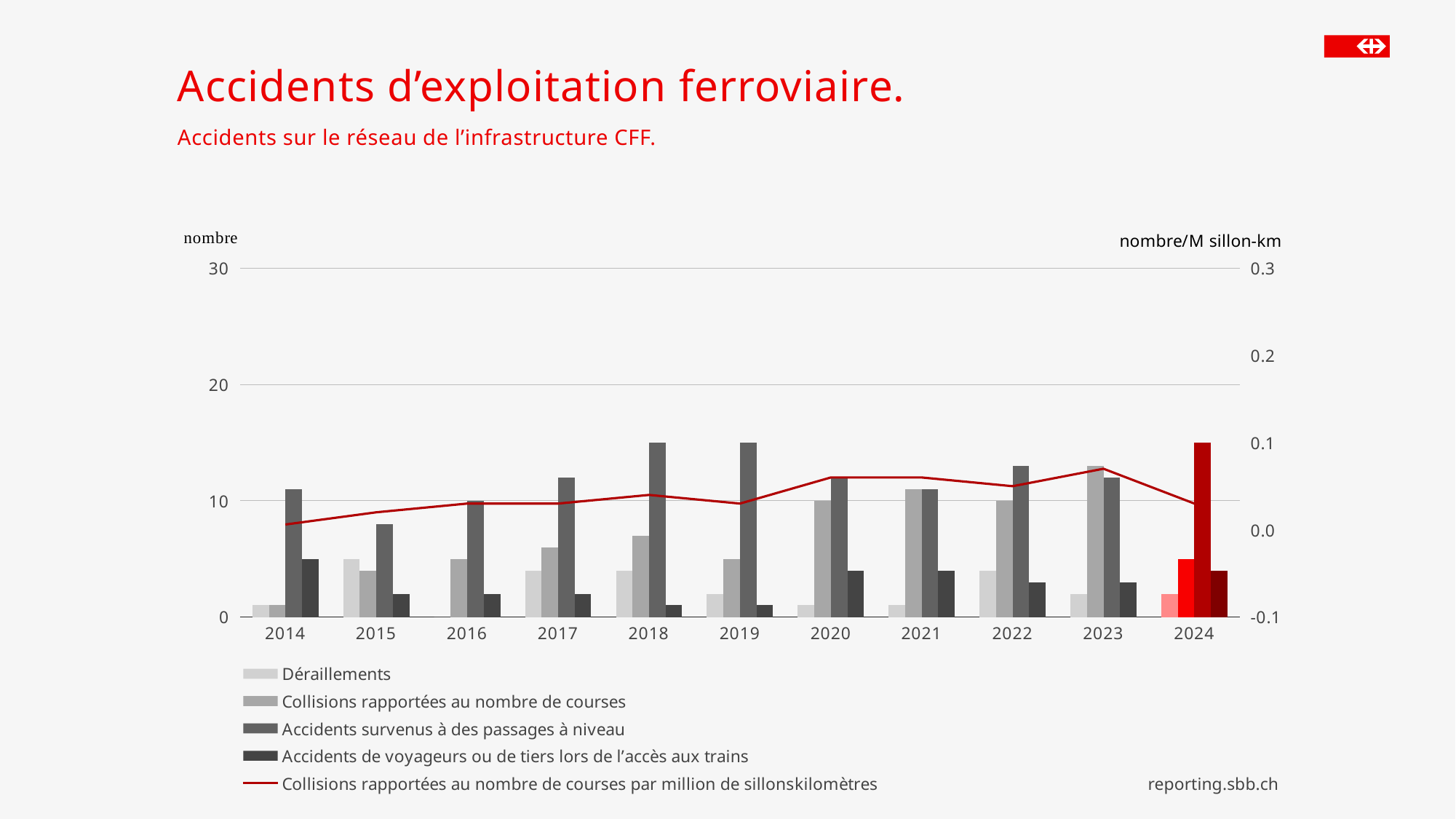
Which is larger: 'Collisions rapportées au nombre de courses' in 2014 or in 2023? 2023 What is the label of the right-hand vertical axis of the chart? nombre/M sillon-km How many years are shown on the x axis of the chart? 11 How many series does the chart legend list? 5 Is the value for 'Déraillements' in 2015 greater or less than 10? less Is the value for 'Accidents survenus à des passages à niveau' in 2018 greater or less than 10? greater Is the value for 'Collisions rapportées au nombre de courses' in 2023 greater or less than 20? less In which year is 'Collisions rapportées au nombre de courses' highest? 2023 Which is larger: 'Accidents survenus à des passages à niveau' in 2015 or in 2018? 2018 Does the line 'Collisions rapportées au nombre de courses par million de sillonskilomètres' rise or fall from 2014 to 2020? rise What kind of chart is shown on the slide? bar chart with a line